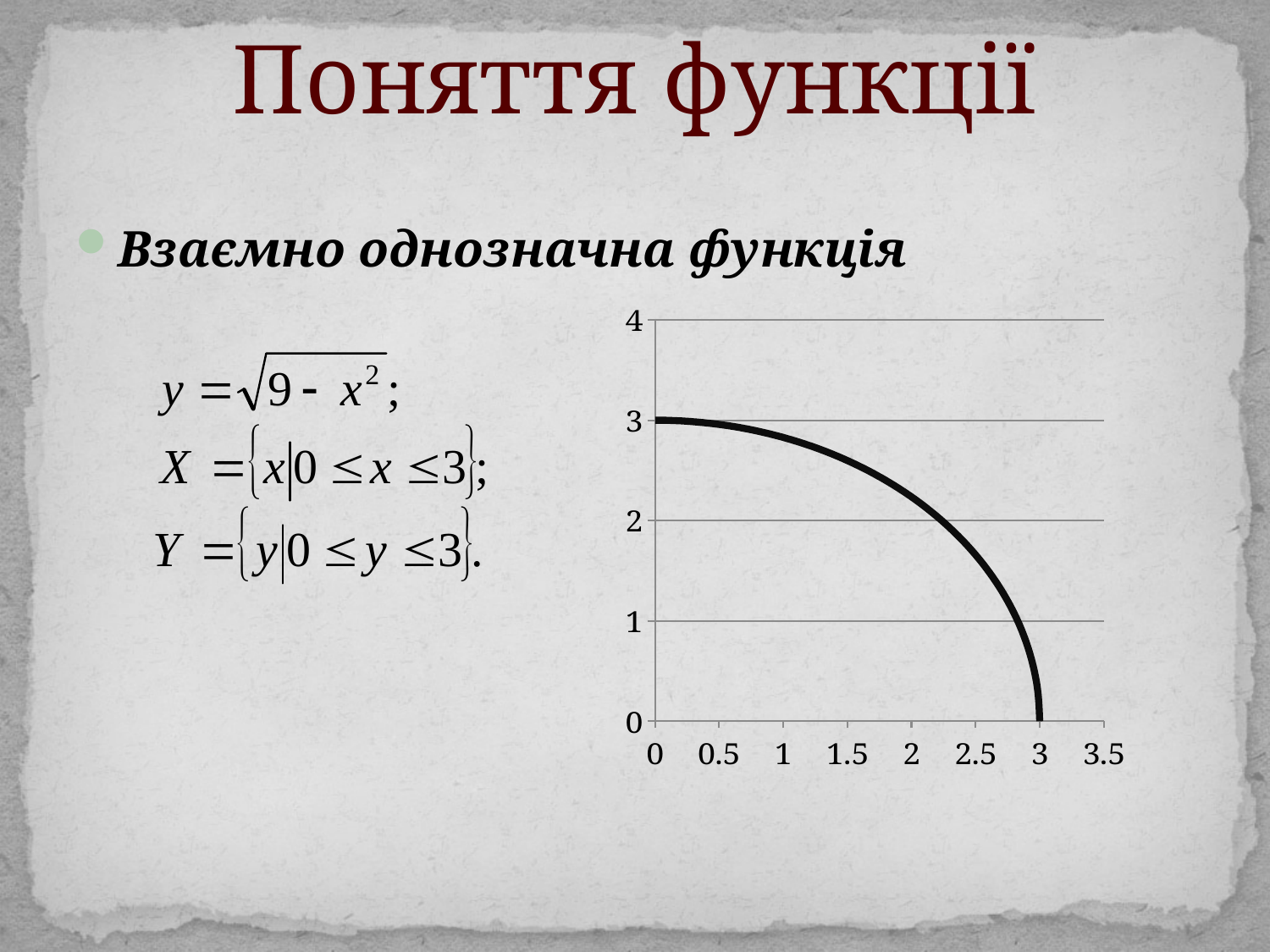
What is the value of y on the chart when x = 0? 3 What is the value of y on the chart when x = 3? 0 Is the value of y at x = 1 greater or less than 2? greater Is the value of y at x = 2.5 greater or less than 1? greater Do the values on the chart rise or fall as x increases from 0 to 3? fall What is the highest tick label shown on the vertical axis of the chart? 4 Is the value of y at x = 2.5 greater or less than 2? less What is the highest tick label shown on the horizontal axis of the chart? 3.5 What kind of chart is shown on the slide? line chart At which x value does the curve reach its highest y value? 0 At which x value does the curve reach its lowest y value? 3